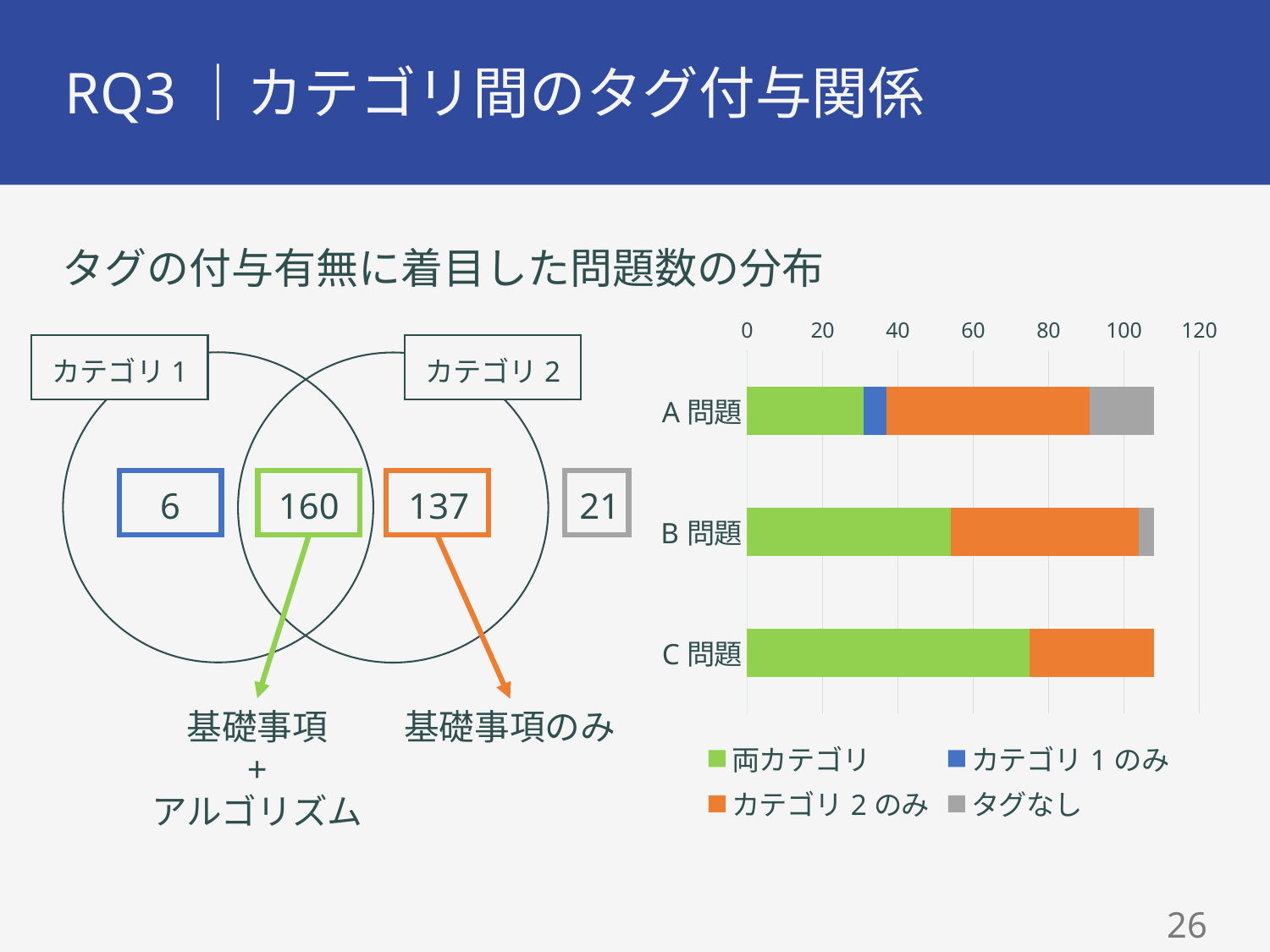
Is the 両カテゴリ value for B 問題 greater or less than 40? greater Is the 両カテゴリ value for A 問題 greater or less than 40? less Which category has the shortest 両カテゴリ segment in the bar chart? A 問題 What colour represents タグなし in the bar chart legend? grey Which category is the only one with a visible カテゴリ 1 のみ segment in the bar chart? A 問題 Which is larger, the カテゴリ 2 のみ segment for A 問題 or for C 問題? A 問題 Is the 両カテゴリ value for C 問題 greater or less than 60? greater How many categories (problem groups) are plotted on the bar chart? 3 Which is larger, the 両カテゴリ value for A 問題 or for C 問題? C 問題 What kind of chart is shown on the right of the slide? bar chart How many series does the legend of the bar chart list? 4 Which category has the longest 両カテゴリ segment in the bar chart? C 問題